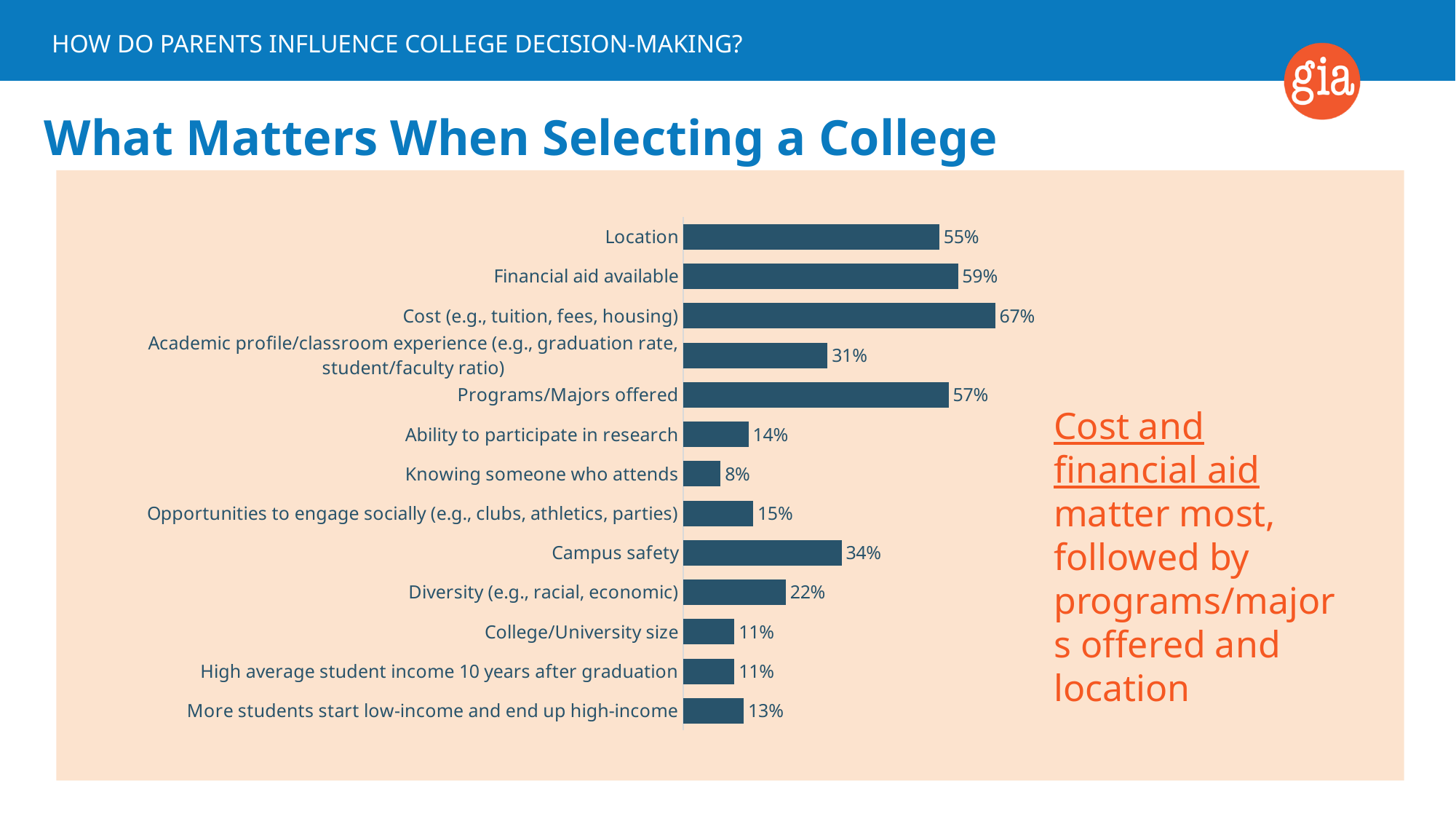
Which is larger, the value for Campus safety or the value for Diversity (e.g., racial, economic)? Campus safety What is the title of the slide containing the chart? What Matters When Selecting a College What kind of chart is shown on the slide? Bar chart What is the value for Knowing someone who attends? 8% How many categories are shown in the chart? 13 Which category has the lowest value? Knowing someone who attends What is the value for Cost (e.g., tuition, fees, housing)? 67% What is the difference between the values for Cost (e.g., tuition, fees, housing) and Ability to participate in research? 53% What is the value for Programs/Majors offered? 57% What is the difference between the values for Financial aid available and Location? 4% What is the value for Campus safety? 34% Which category has the highest value? Cost (e.g., tuition, fees, housing)